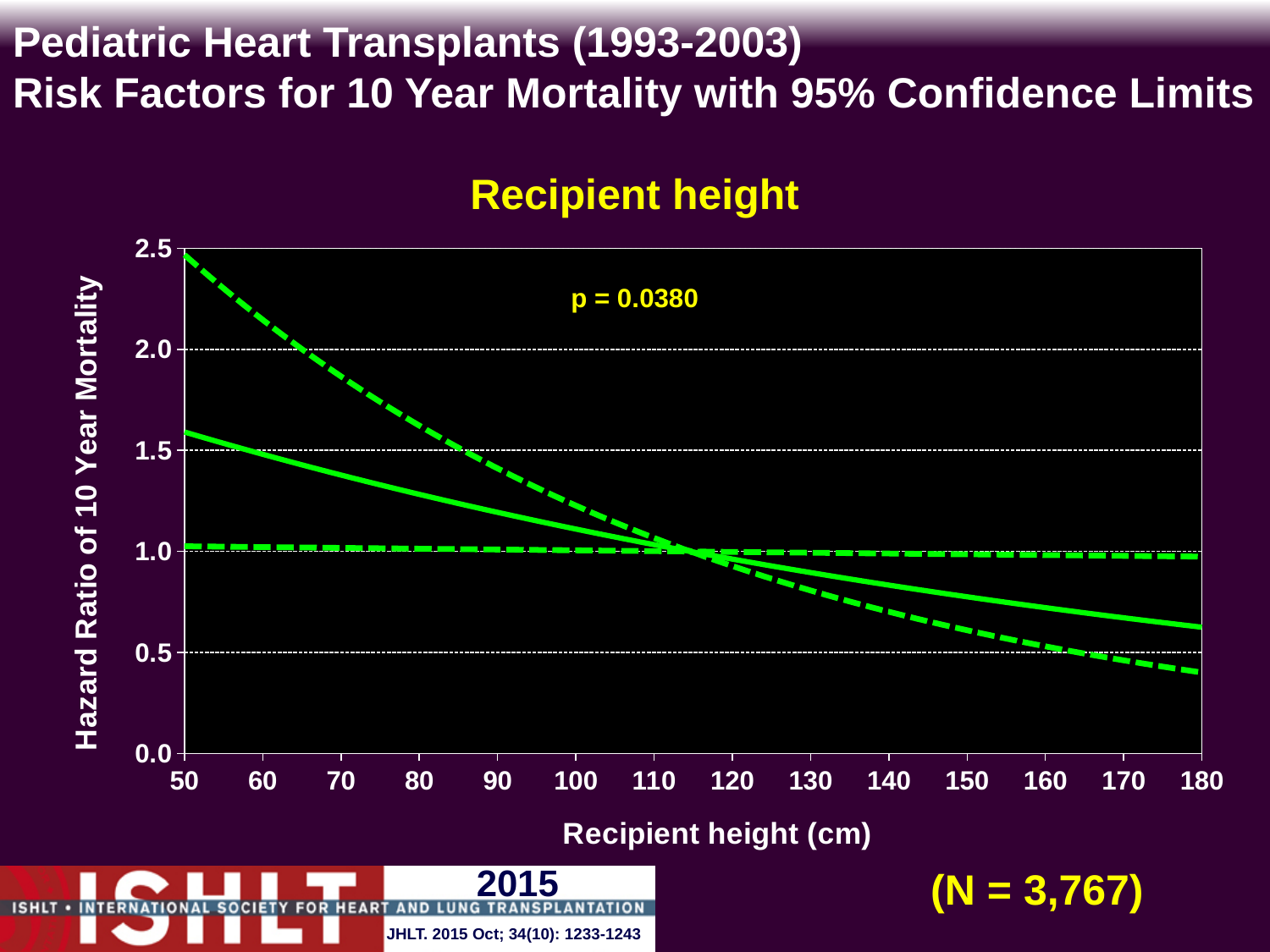
What kind of chart is shown on the slide? line chart How many tick labels are shown on the x axis? 14 Does the solid hazard ratio line rise or fall as recipient height increases from 50 cm to 180 cm? fall What is the label of the y axis? Hazard Ratio of 10 Year Mortality How many lines are plotted on the chart? 3 What p-value is printed on the chart? p = 0.0380 Is the lower dashed confidence limit at a recipient height of 180 cm greater or less than 0.5? less Is the solid hazard ratio line at a recipient height of 150 cm greater or less than 1.0? less Is the solid hazard ratio line at a recipient height of 80 cm greater or less than 1.0? greater